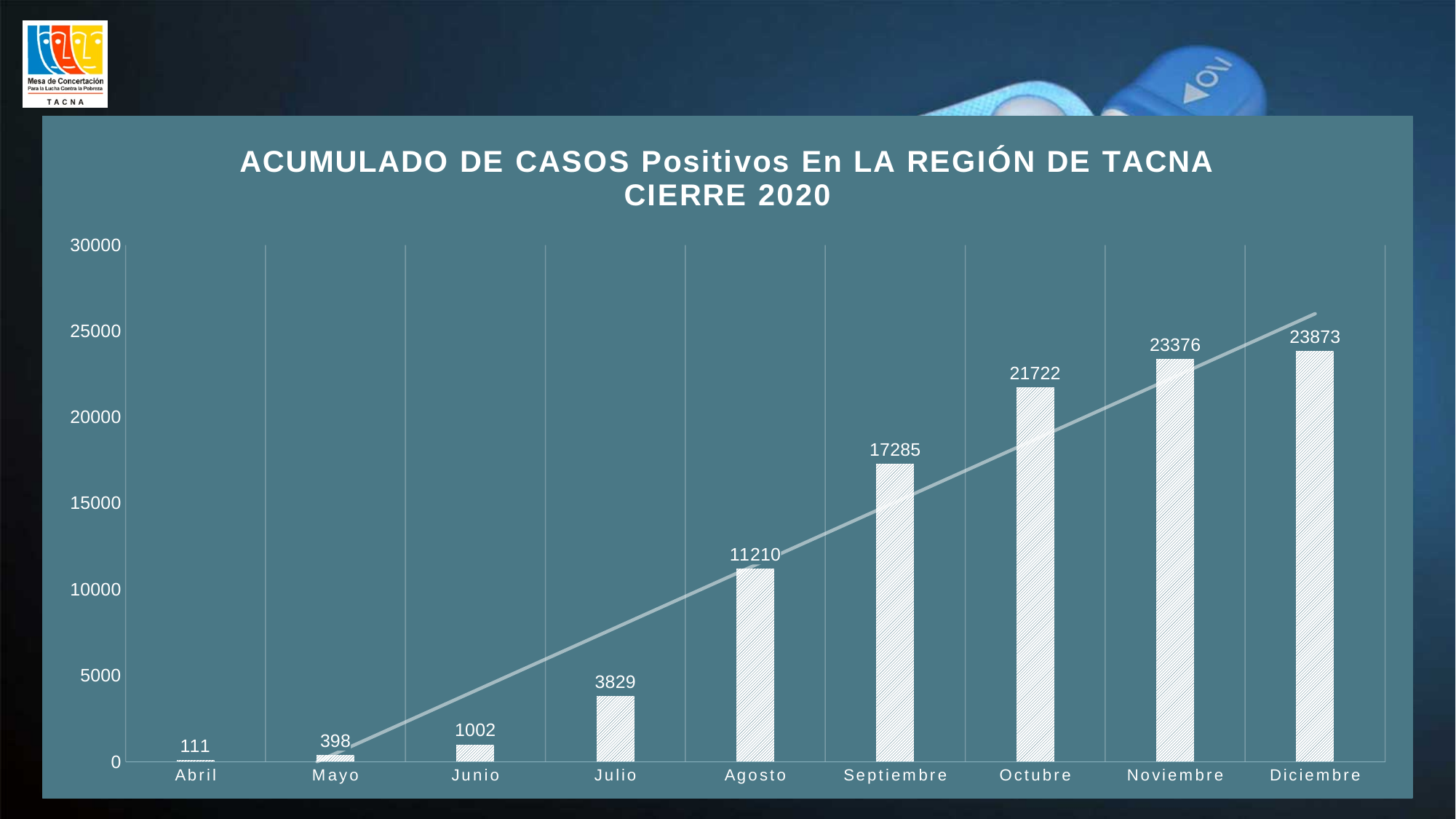
Which is larger, the value for Julio or the value for Junio? Julio What kind of chart is this? bar chart What is the value for Octubre? 21722 What value is shown for Abril? 111 What is the difference between the values for Septiembre and Agosto? 6075 Which month has the highest accumulated number of cases? Diciembre How many months are shown on the x axis? 9 Which month has the lowest accumulated number of cases? Abril What is the accumulated number of positive cases for Agosto? 11210 What is the difference between the values for Diciembre and Noviembre? 497 Do the values rise or fall from Abril to Diciembre? rise Is the value for Septiembre greater or less than 15000? greater